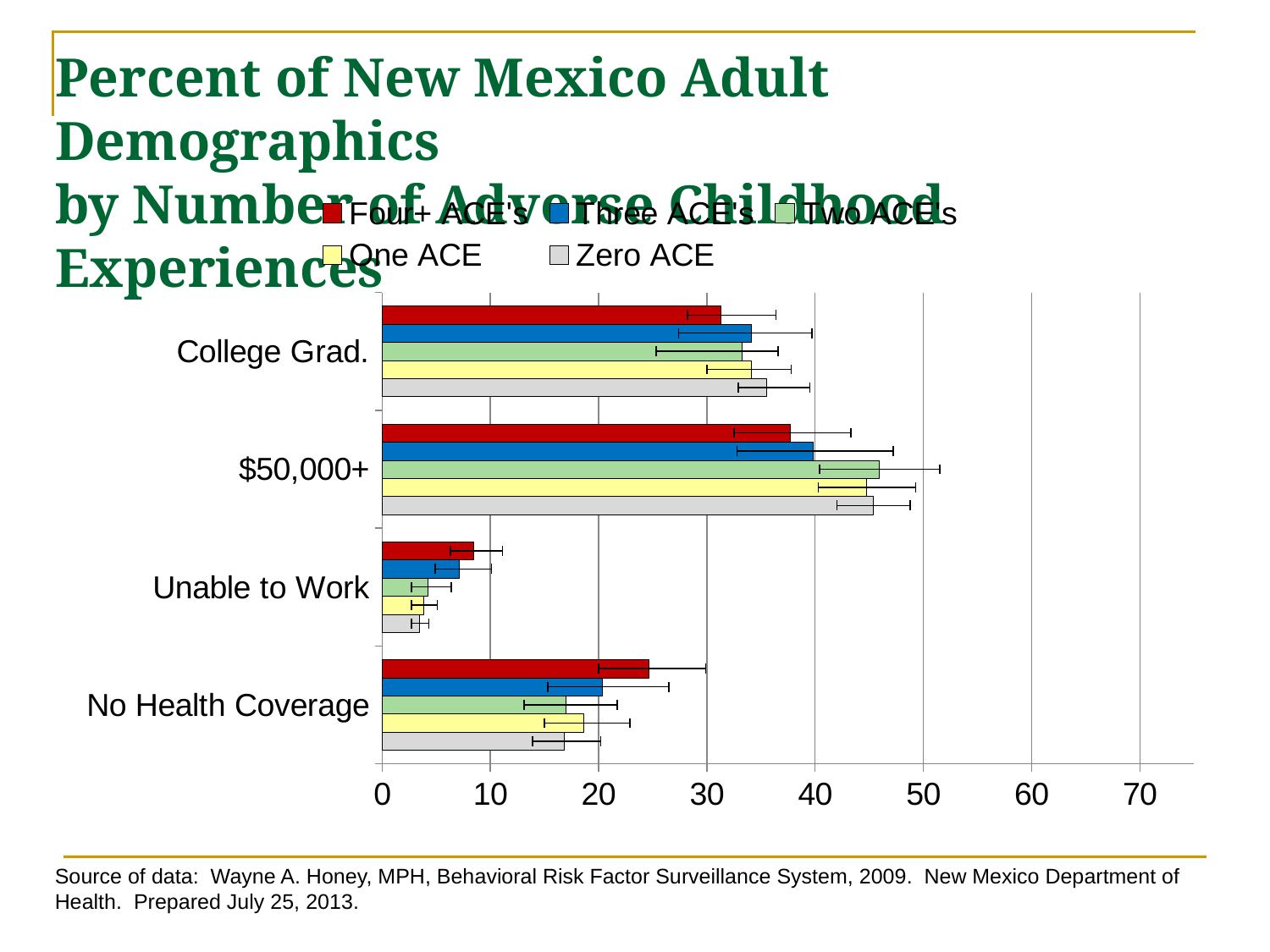
Which is larger for the Unable to Work category: Four+ ACE's or Zero ACE? Four+ ACE's How many demographic categories are shown on the chart? 4 Which series has the highest value in the No Health Coverage category? Four+ ACE's Which demographic category has the lowest values across all series? Unable to Work Which series is shown in red on the chart? Four+ ACE's Is the value for Zero ACE in the No Health Coverage category greater or less than 20? less How many series does the chart legend list? 5 Which is larger for the $50,000+ category: Two ACE's or Four+ ACE's? Two ACE's Is the value for Two ACE's in the $50,000+ category greater or less than 40? greater What kind of chart is shown on the slide? Bar chart Is the value for Four+ ACE's in the No Health Coverage category greater or less than 20? greater